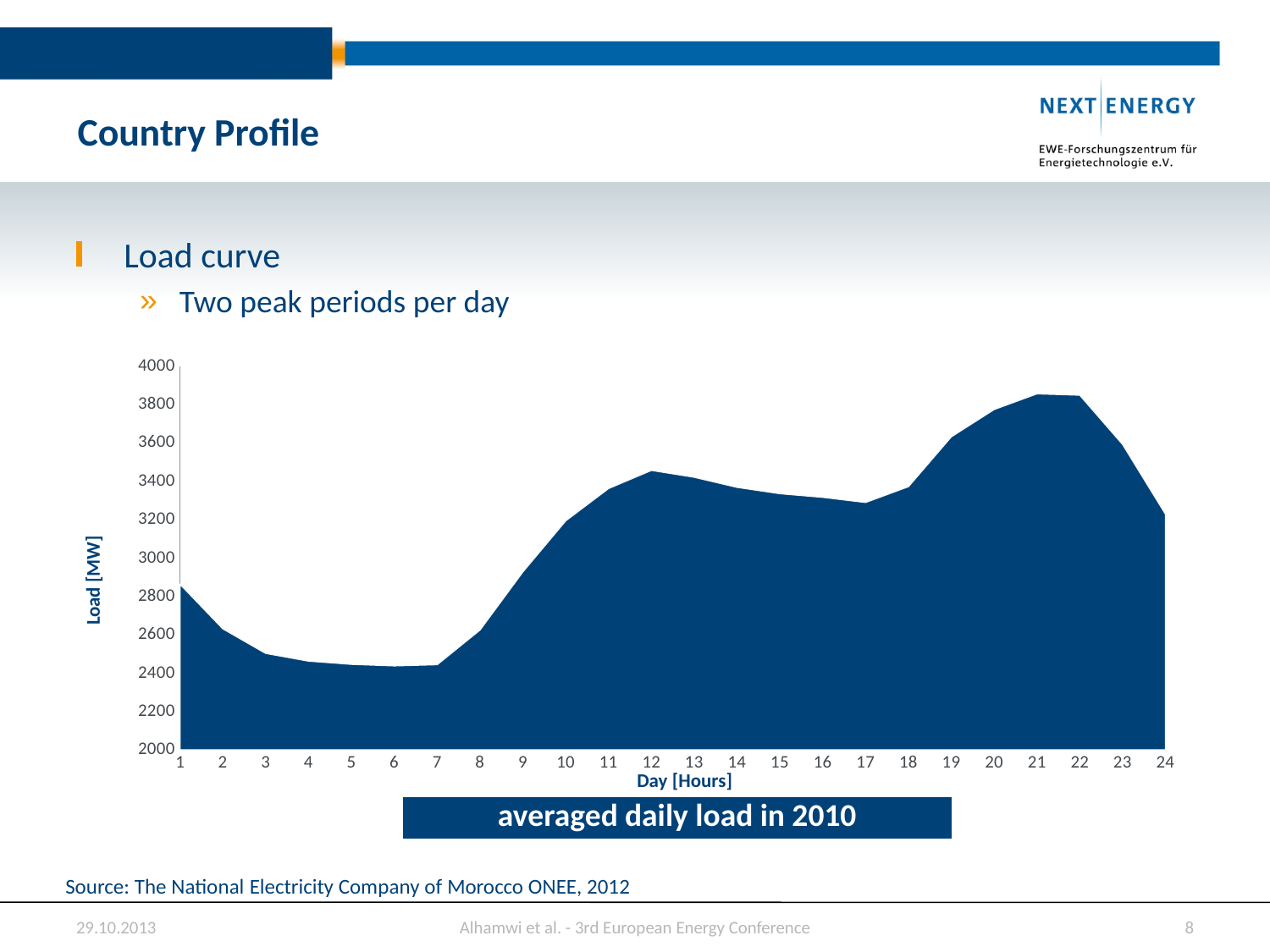
What is the title of the y axis? Load [MW] Is the load at hour 12 greater or less than 3200 MW? greater What kind of chart is shown on the slide? Area chart Is the load at hour 1 greater or less than 2600 MW? greater Is the load at hour 17 greater or less than 3400 MW? less Which is larger, the load at hour 1 or the load at hour 6? Hour 1 How many hourly points are plotted along the x axis? 24 Does the load rise or fall from hour 7 to hour 12? Rises Which is larger, the load at hour 12 or the load at hour 21? Hour 21 What caption is shown below the chart? averaged daily load in 2010